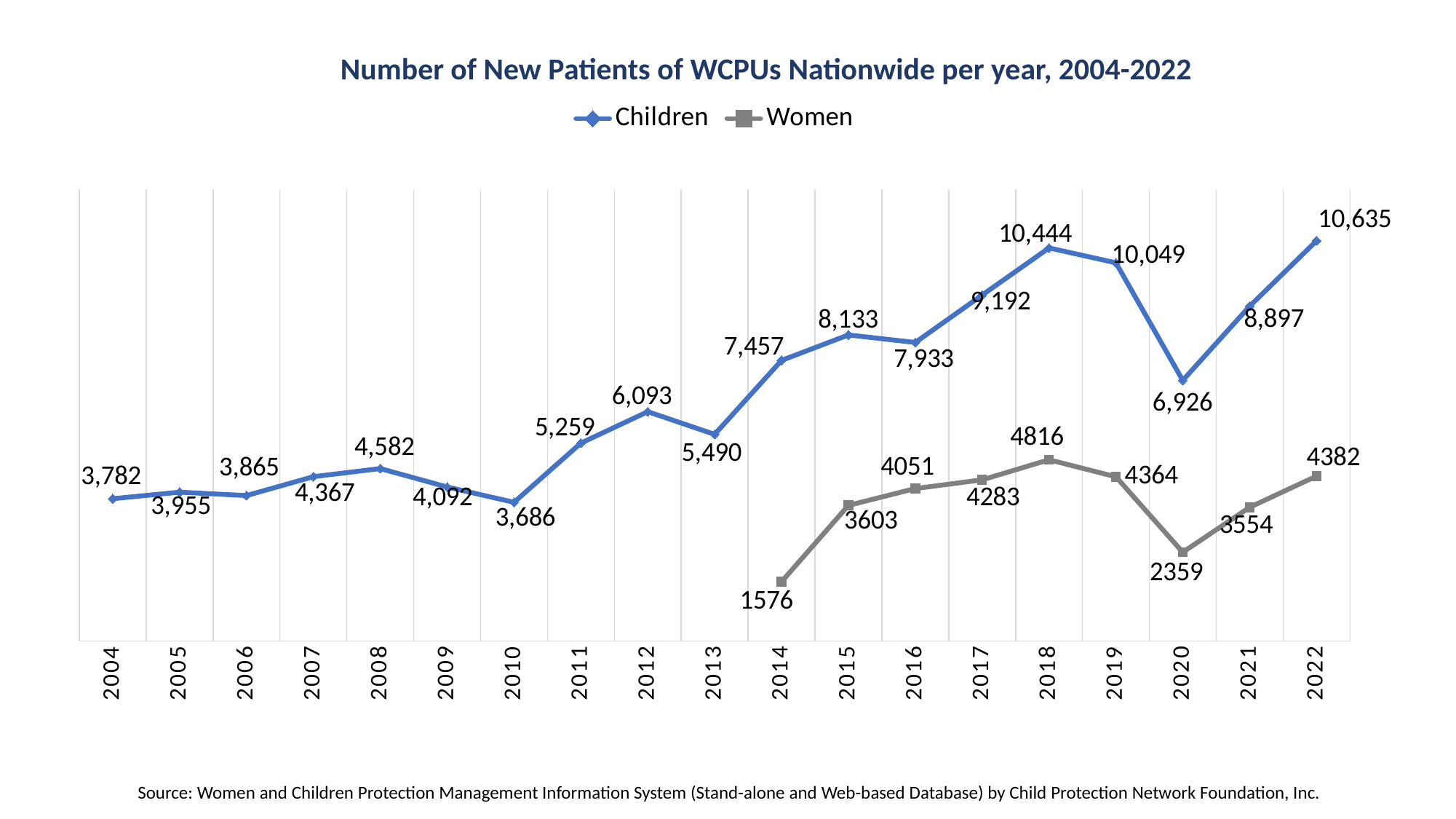
What is the difference between the Women values for 2018 and 2017? 533 How many years are shown on the x axis? 19 In which year is the Children series at its highest? 2022 What is the number of new Children patients in 2010? 3,686 What is the number of new Women patients in 2020? 2359 What is the number of new Children patients in 2018? 10,444 Which year has the larger Children value, 2018 or 2019? 2018 What is the difference between the Children values for 2022 and 2021? 1,738 In which year is the Women series at its lowest? 2014 What kind of chart is shown on the slide? Line chart How many series does the legend list? 2 Does the Children series overall rise or fall from 2004 to 2022? Rise